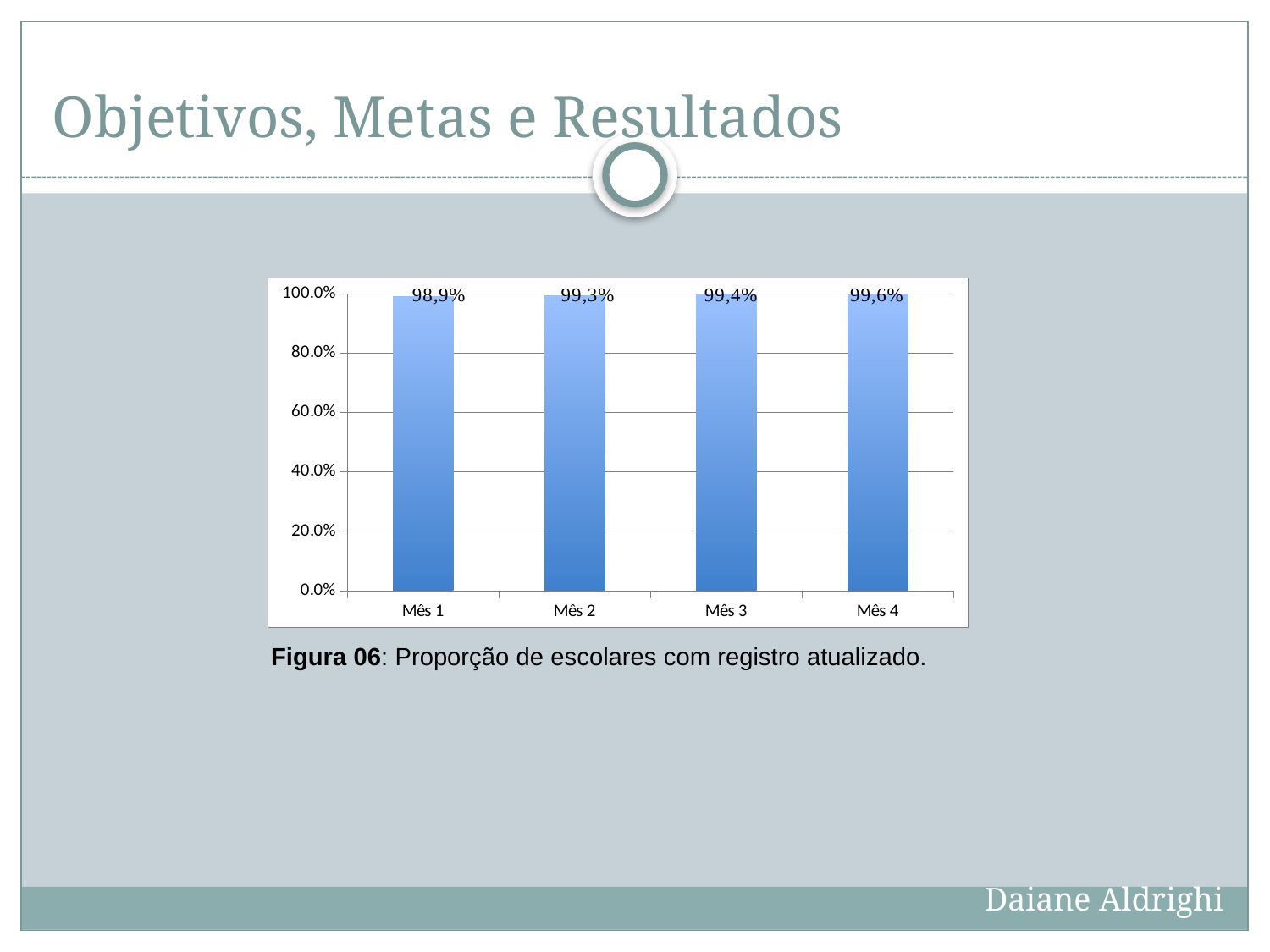
What is the difference between the values for Mês 4 and Mês 1? 0,7% Which month has the highest value? Mês 4 What is the value for Mês 3? 99,4% Is the value for Mês 2 greater or less than 80.0%? greater Do the values rise or fall from Mês 1 to Mês 4? rise What kind of chart is shown? bar chart What is the value for Mês 2? 99,3% Which month has the lowest value? Mês 1 Which has a larger value according to the data labels, Mês 2 or Mês 3? Mês 3 What is the value for Mês 4? 99,6% What is the value for Mês 1? 98,9% How many months are shown on the x axis? 4